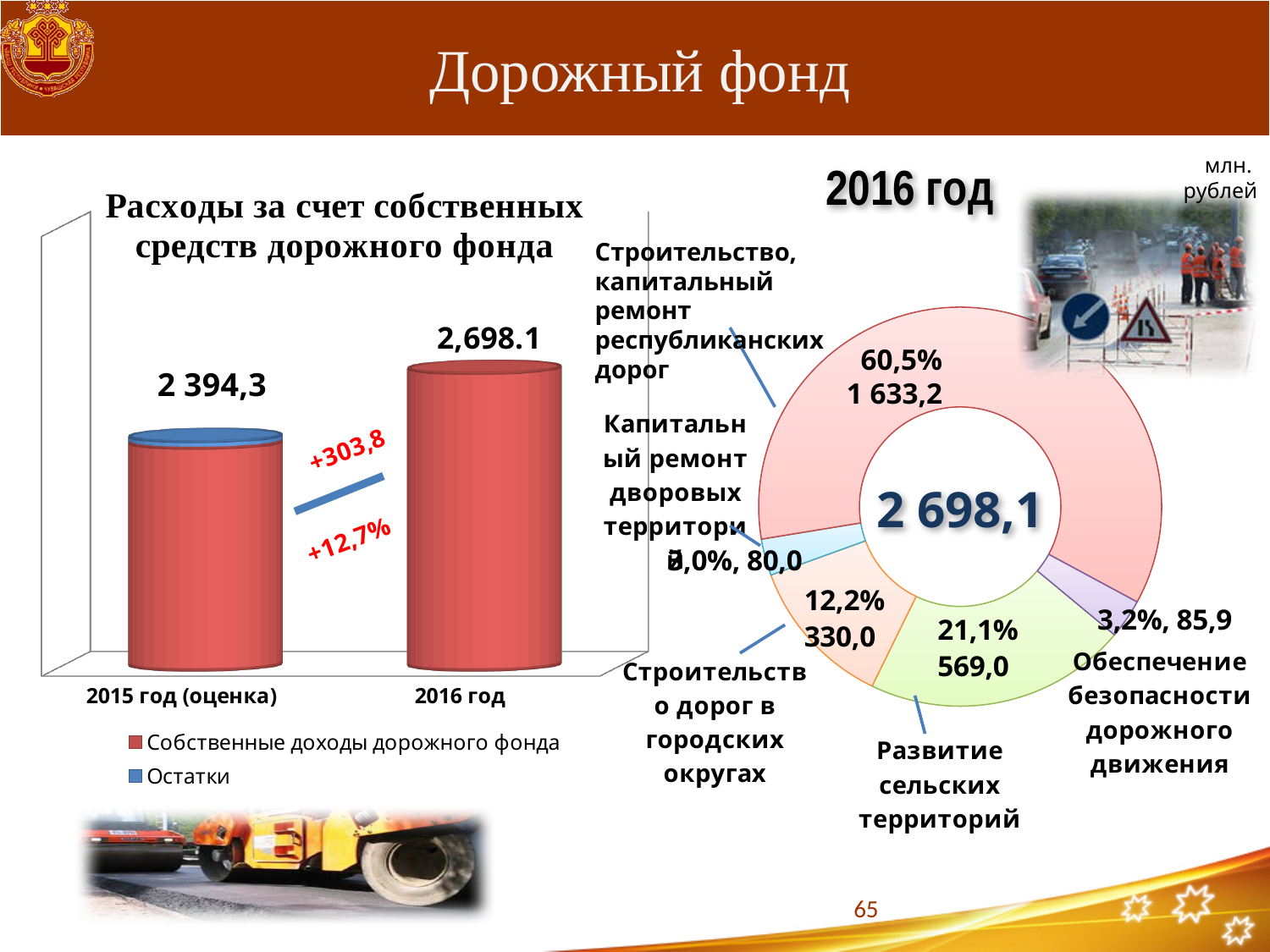
In the bar chart on the left, which year has the higher value? 2016 год What kind of chart is the '2016 год' chart on the right of the slide? doughnut chart In the '2016 год' doughnut chart, which category has the largest slice? Строительство, капитальный ремонт республиканских дорог In the '2016 год' doughnut chart, what total is shown in the centre? 2 698,1 In the '2016 год' doughnut chart, what share does Строительство, капитальный ремонт республиканских дорог have? 60,5% In the bar chart on the left, what increase is shown between 2015 год (оценка) and 2016 год? +303,8 What kind of chart is the chart on the left of the slide? bar chart How many series does the legend of the bar chart on the left list? 2 In the '2016 год' doughnut chart, what is the value for Развитие сельских территорий? 569,0 In the bar chart 'Расходы за счет собственных средств дорожного фонда', what is the value for 2015 год (оценка)? 2 394,3 In the bar chart 'Расходы за счет собственных средств дорожного фонда', what is the value for 2016 год? 2,698.1 In the bar chart on the left, what percentage change is shown between the two years? +12,7%